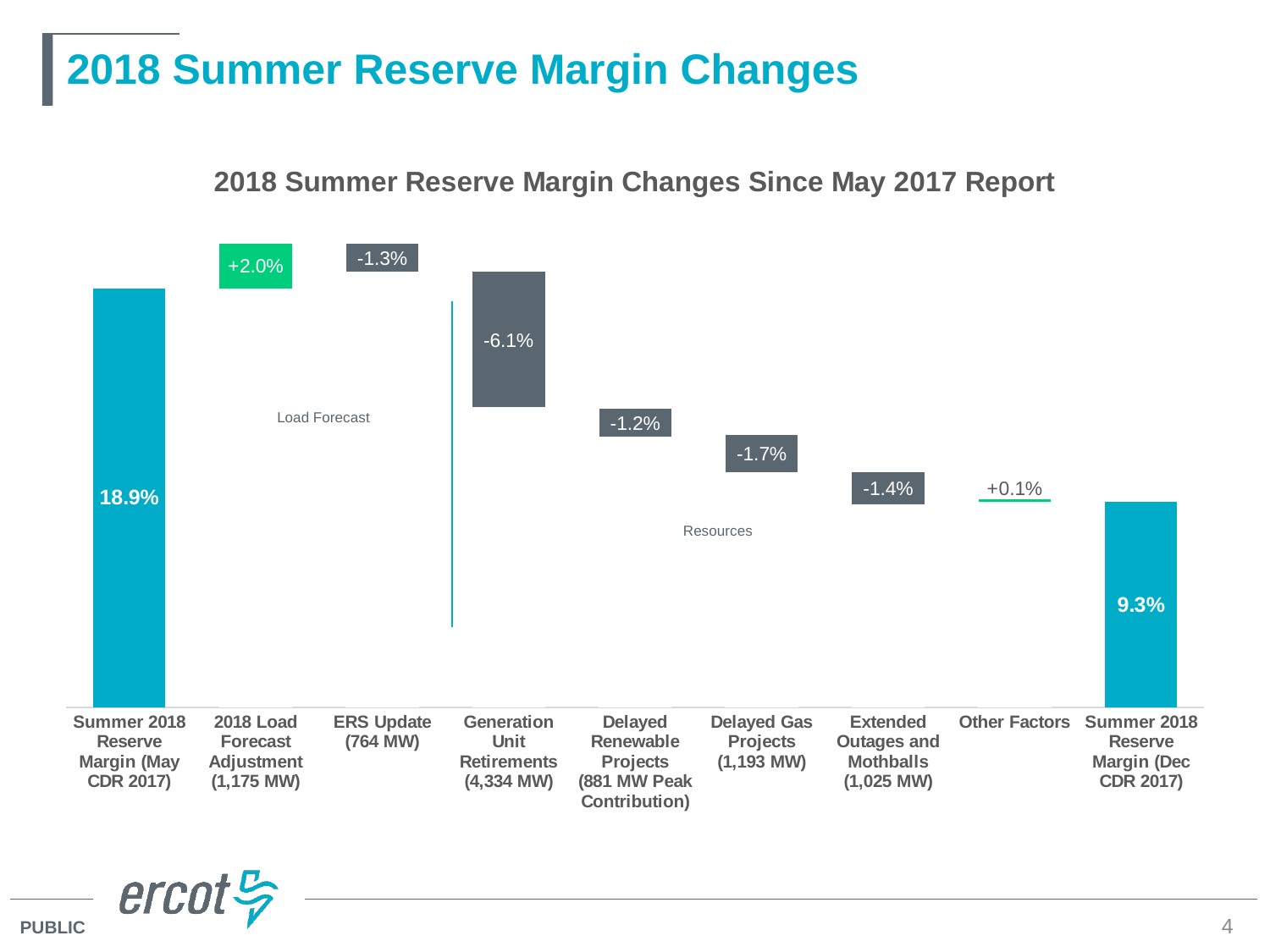
What change is shown for Other Factors? +0.1% What change is shown for the 2018 Load Forecast Adjustment (1,175 MW)? +2.0% Which category shows the largest negative change? Generation Unit Retirements (4,334 MW) How many categories are shown along the x axis of the chart? 9 What change is shown for Delayed Gas Projects (1,193 MW)? -1.7% What is the value shown for Summer 2018 Reserve Margin (Dec CDR 2017)? 9.3% What is the title of the chart? 2018 Summer Reserve Margin Changes Since May 2017 Report What change is shown for Generation Unit Retirements (4,334 MW)? -6.1% Which category shows the largest positive change? 2018 Load Forecast Adjustment (1,175 MW) What is the value shown for Summer 2018 Reserve Margin (May CDR 2017)? 18.9% By how many percentage points did the reserve margin fall from the May CDR 2017 value to the Dec CDR 2017 value? 9.6 percentage points Which has the larger negative change, ERS Update (764 MW) or Extended Outages and Mothballs (1,025 MW)? Extended Outages and Mothballs (1,025 MW)